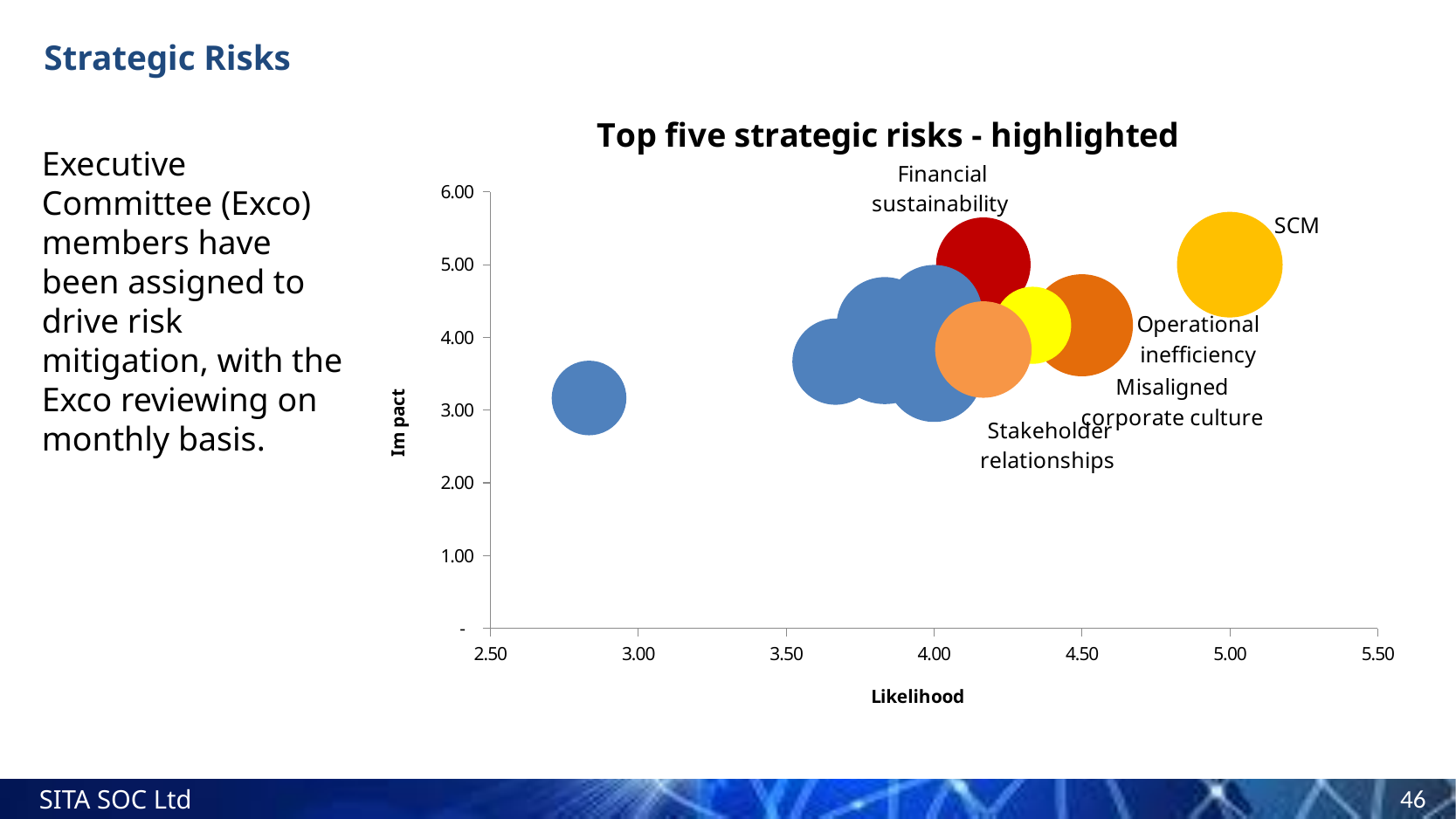
Which has the higher likelihood, SCM or Financial sustainability? SCM How many strategic risks are labelled by name on the chart? 5 Is the impact for Financial sustainability greater or less than 4.00? greater Is the impact for Misaligned corporate culture greater or less than 5.00? less Is the likelihood for Operational inefficiency greater or less than 4.00? greater Which has the higher impact, Financial sustainability or Operational inefficiency? Financial sustainability Which has the higher likelihood, Operational inefficiency or Financial sustainability? Operational inefficiency What is the label of the horizontal axis of the chart? Likelihood Which labelled risk has the highest likelihood on the chart? SCM What is the title of the chart? Top five strategic risks - highlighted What kind of chart is shown on the slide? Bubble chart